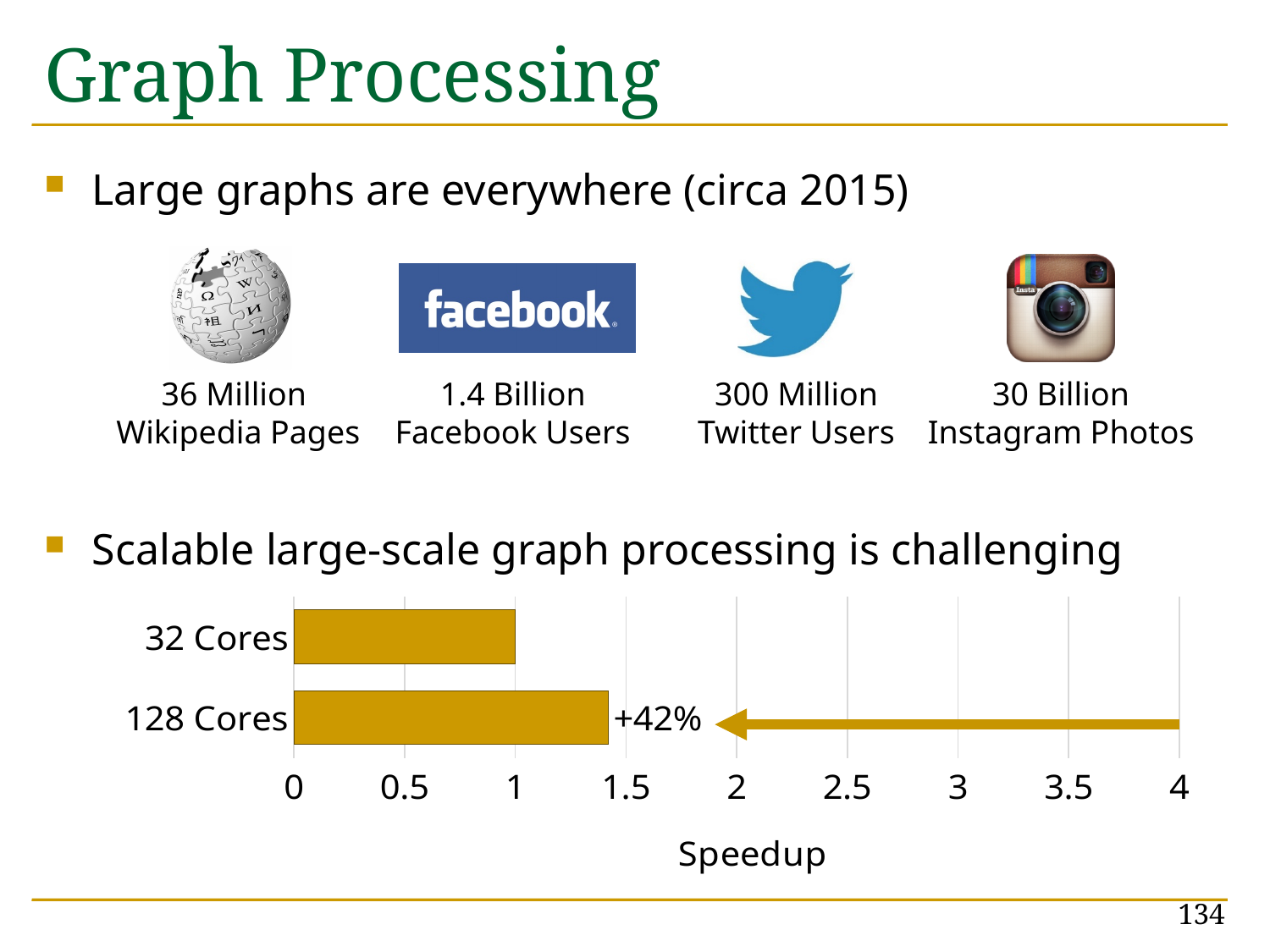
What is the title of the x axis of the chart? Speedup What annotation is printed next to the 128 Cores bar? +42% Which is larger, the speedup for 128 Cores or for 32 Cores? 128 Cores Is the speedup for 128 Cores greater or less than 2? less What is the maximum value shown on the x axis of the chart? 4 What kind of chart is shown at the bottom of the slide? bar chart Which category has the lower speedup in the chart? 32 Cores How many categories are plotted in the Speedup chart? 2 Which category has the higher speedup in the chart? 128 Cores Is the speedup for 128 Cores greater or less than 1? greater What is the speedup value for 32 Cores? 1 Is the speedup for 32 Cores greater or less than 2? less